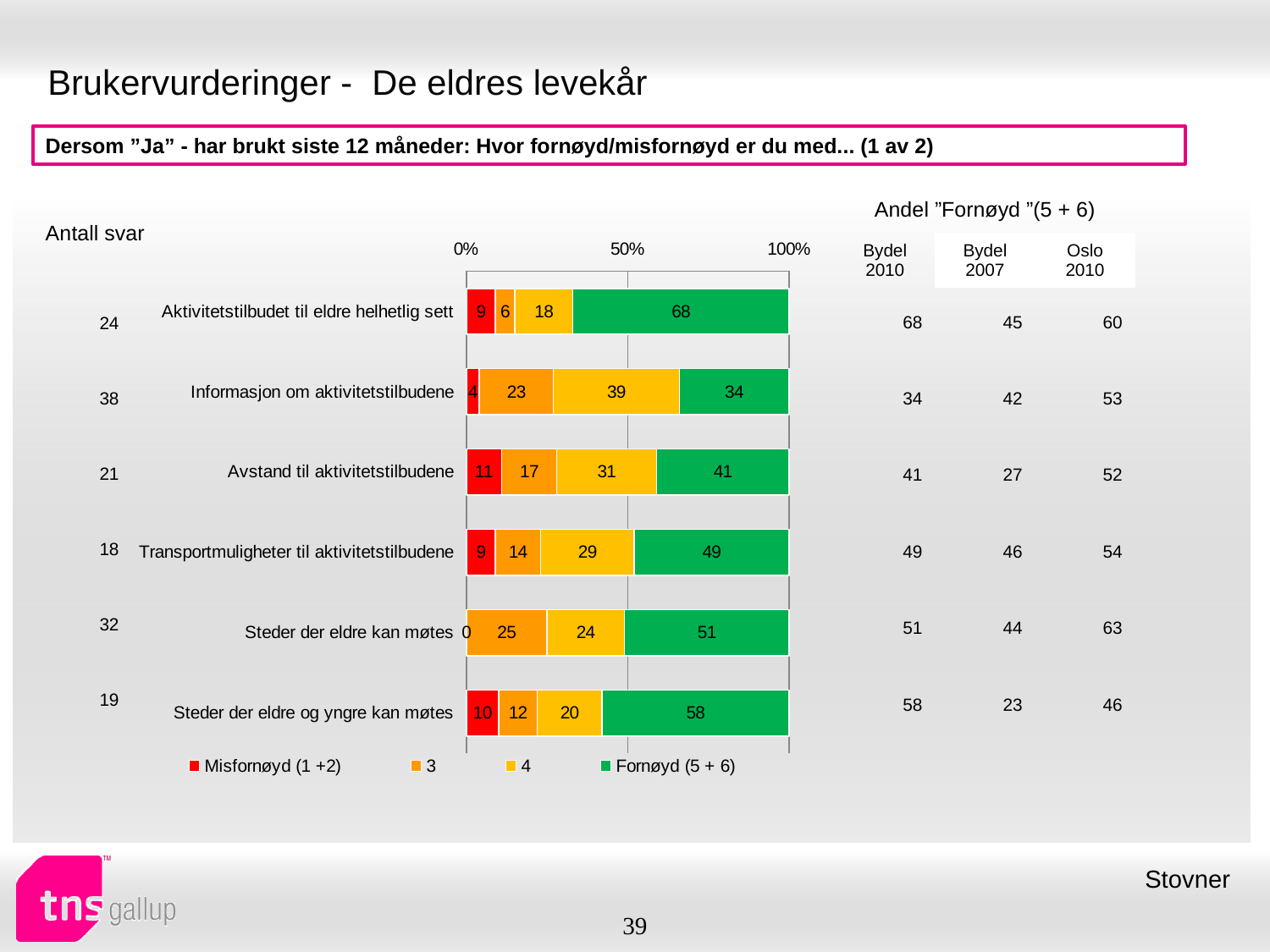
What is the value of the "3" segment for "Informasjon om aktivitetstilbudene"? 23 How many series does the legend list? 4 What kind of chart is shown on the slide? Stacked bar chart What is the value of the Fornøyd (5 + 6) segment for "Aktivitetstilbudet til eldre helhetlig sett"? 68 What is the total of the stacked bar for "Informasjon om aktivitetstilbudene"? 100 What is the value of the "4" segment for "Transportmuligheter til aktivitetstilbudene"? 29 Which category has the lowest Fornøyd (5 + 6) value? Informasjon om aktivitetstilbudene Which has the larger Misfornøyd (1 +2) value: "Avstand til aktivitetstilbudene" or "Steder der eldre og yngre kan møtes"? Avstand til aktivitetstilbudene Which category has the highest Fornøyd (5 + 6) value? Aktivitetstilbudet til eldre helhetlig sett What is the difference between the Fornøyd (5 + 6) values for "Steder der eldre og yngre kan møtes" and "Steder der eldre kan møtes"? 7 How many categories are shown in the bar chart? 6 What colour represents the Fornøyd (5 + 6) series in the legend? Green